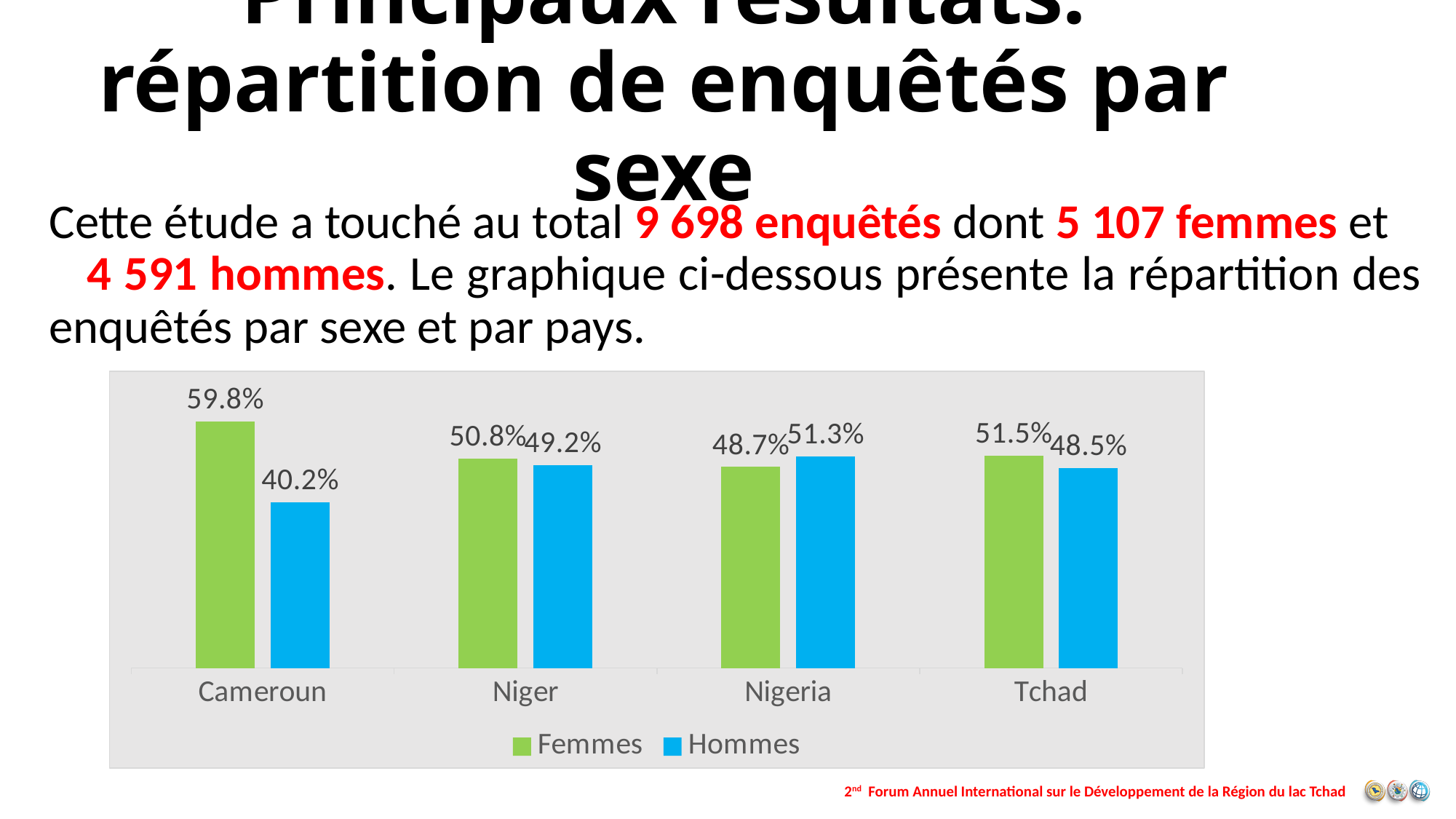
What is the difference between the Femmes and Hommes values for Cameroun? 19.6% How many series does the legend list? 2 What is the Femmes value for Cameroun? 59.8% Which colour represents the Hommes series? Blue What is the Hommes value for Nigeria? 51.3% How many countries are shown on the x axis? 4 For Nigeria, which is larger, the Femmes value or the Hommes value? Hommes What is the Femmes value for Niger? 50.8% Which country has the lowest Hommes value? Cameroun What is the Hommes value for Tchad? 48.5% Which country has the highest Femmes value? Cameroun What kind of chart is shown on the slide? Bar chart